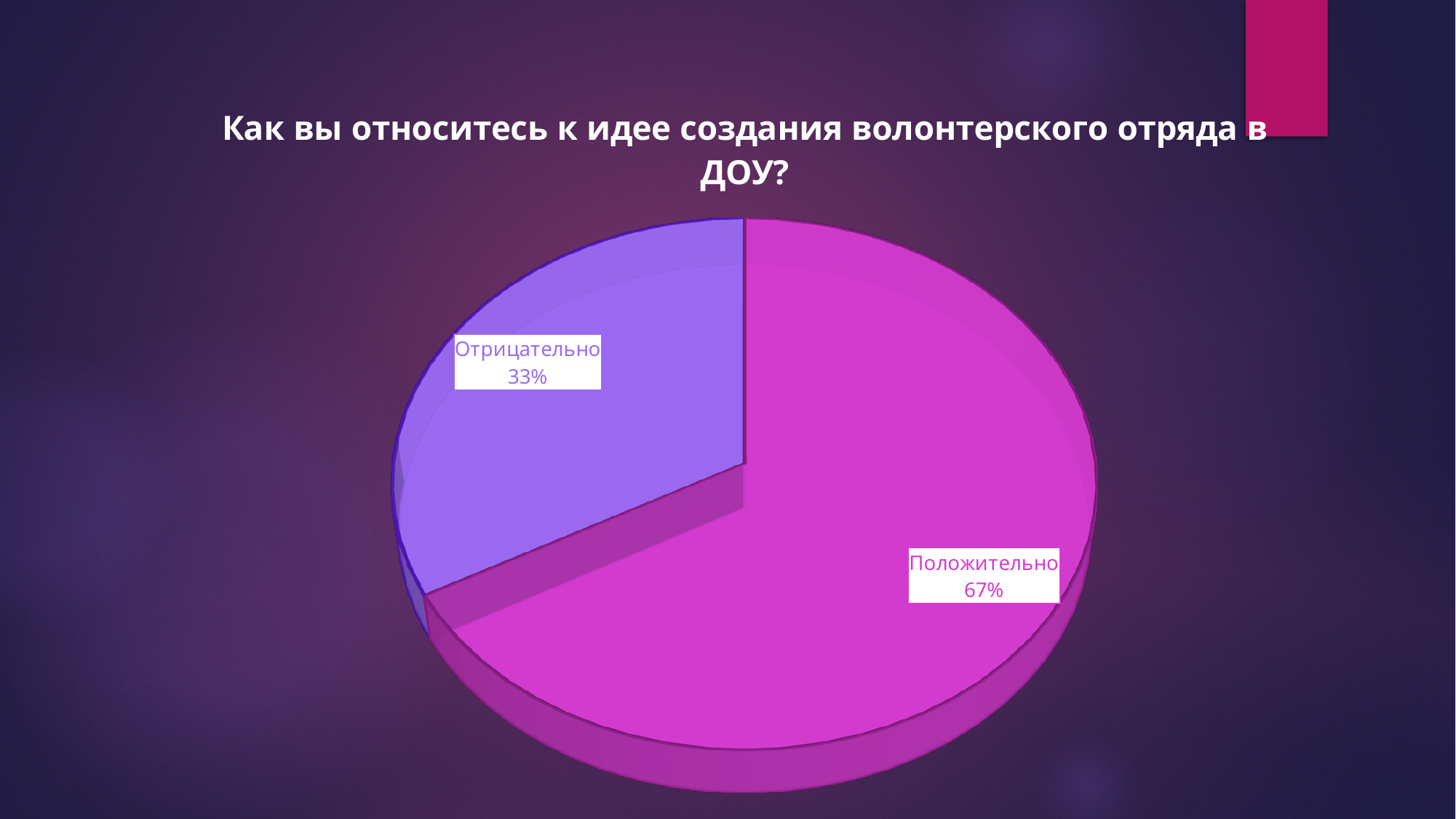
What colour is the "Положительно" slice? Magenta (pink) What is the title of the chart? Как вы относитесь к идее создания волонтерского отряда в ДОУ? What share of the pie does the "Положительно" slice represent? 67% Which slice is the largest in the pie chart? Положительно How many slices does the pie chart have? 2 What kind of chart is shown on the slide? Pie chart What share of the pie does the "Отрицательно" slice represent? 33% What is the difference in percentage points between the "Положительно" and "Отрицательно" slices? 34 Which is larger, the "Положительно" slice or the "Отрицательно" slice? Положительно Which slice is the smallest in the pie chart? Отрицательно